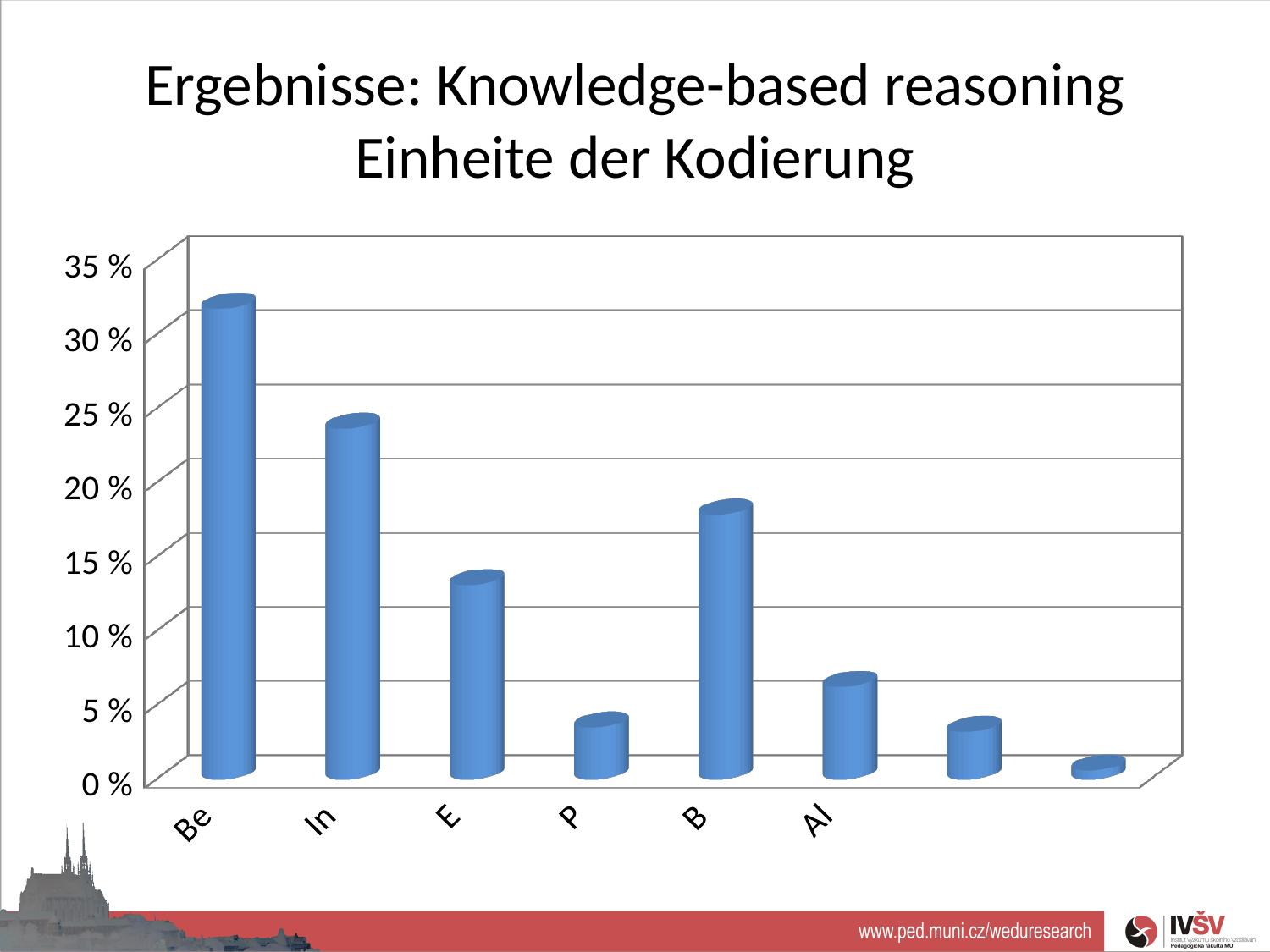
What is the title of the slide containing the chart? Ergebnisse: Knowledge-based reasoning Einheite der Kodierung Which is larger, the value for E or the value for Al? E Is the value for Be greater or less than 30 %? greater How many bars are plotted in the chart? 8 Is the value for E greater or less than 10 %? greater Is the value for B greater or less than 20 %? less Among the labeled categories, which has the lowest value? P Which category has the highest value in the chart? Be Which is larger, the value for In or the value for B? In What kind of chart is shown on the slide? bar chart